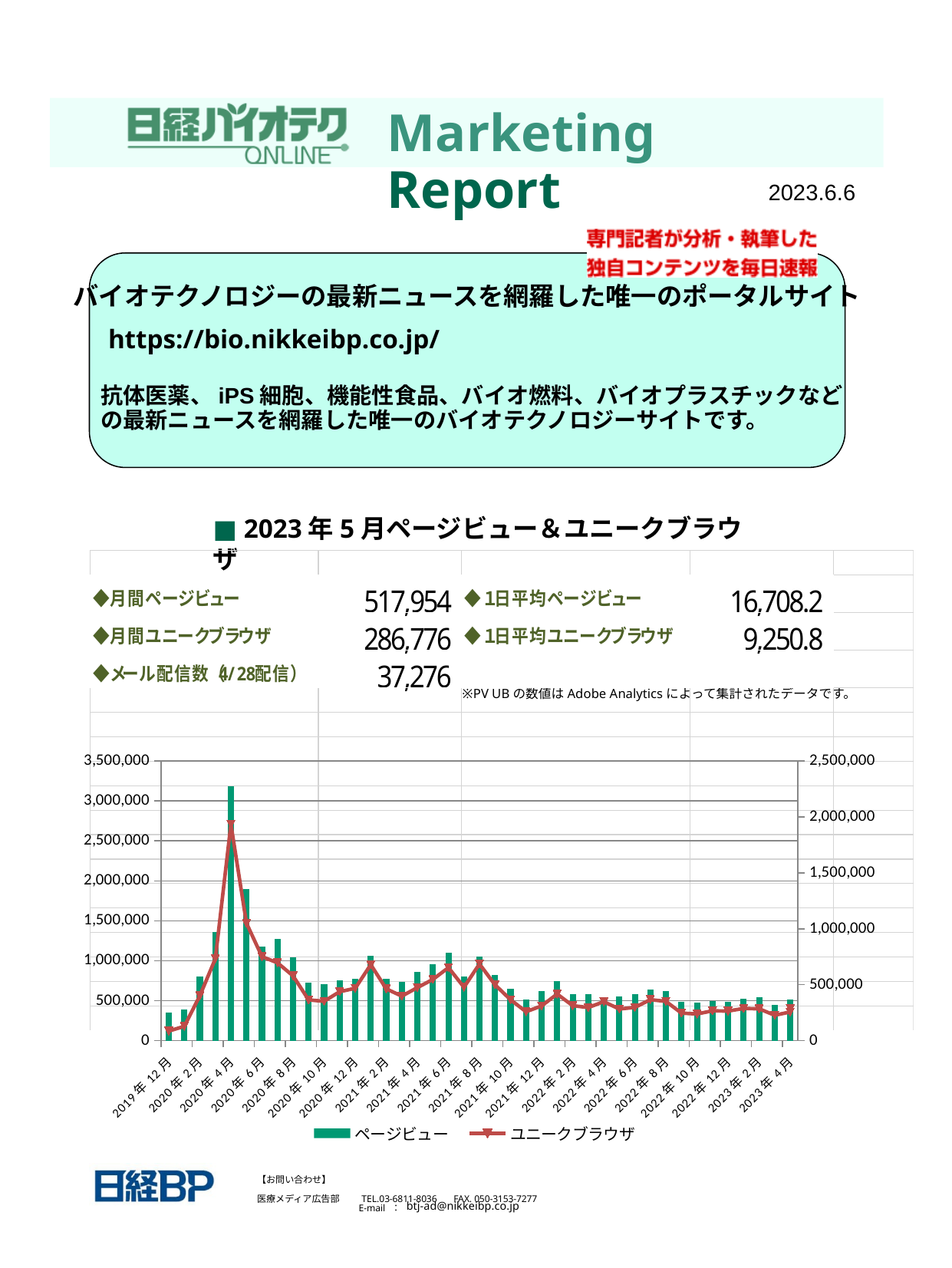
What kind of chart is shown on the slide? Combined bar and line chart Is the ページビュー value for 2019年12月 greater or less than 500,000? less Do the ページビュー bars rise or fall from 2020年4月 to 2020年10月? fall How many series does the chart legend list? 2 Is the ページビュー value for 2020年4月 greater or less than 3,000,000? greater In which month do the ページビュー bars reach their highest value? 2020年4月 Is the ページビュー value for 2020年6月 greater or less than 1,500,000? less What is the highest value shown on the left vertical axis of the chart? 3,500,000 Which series is drawn as bars in the chart? ページビュー Which month has the larger ページビュー value, 2020年4月 or 2020年6月? 2020年4月